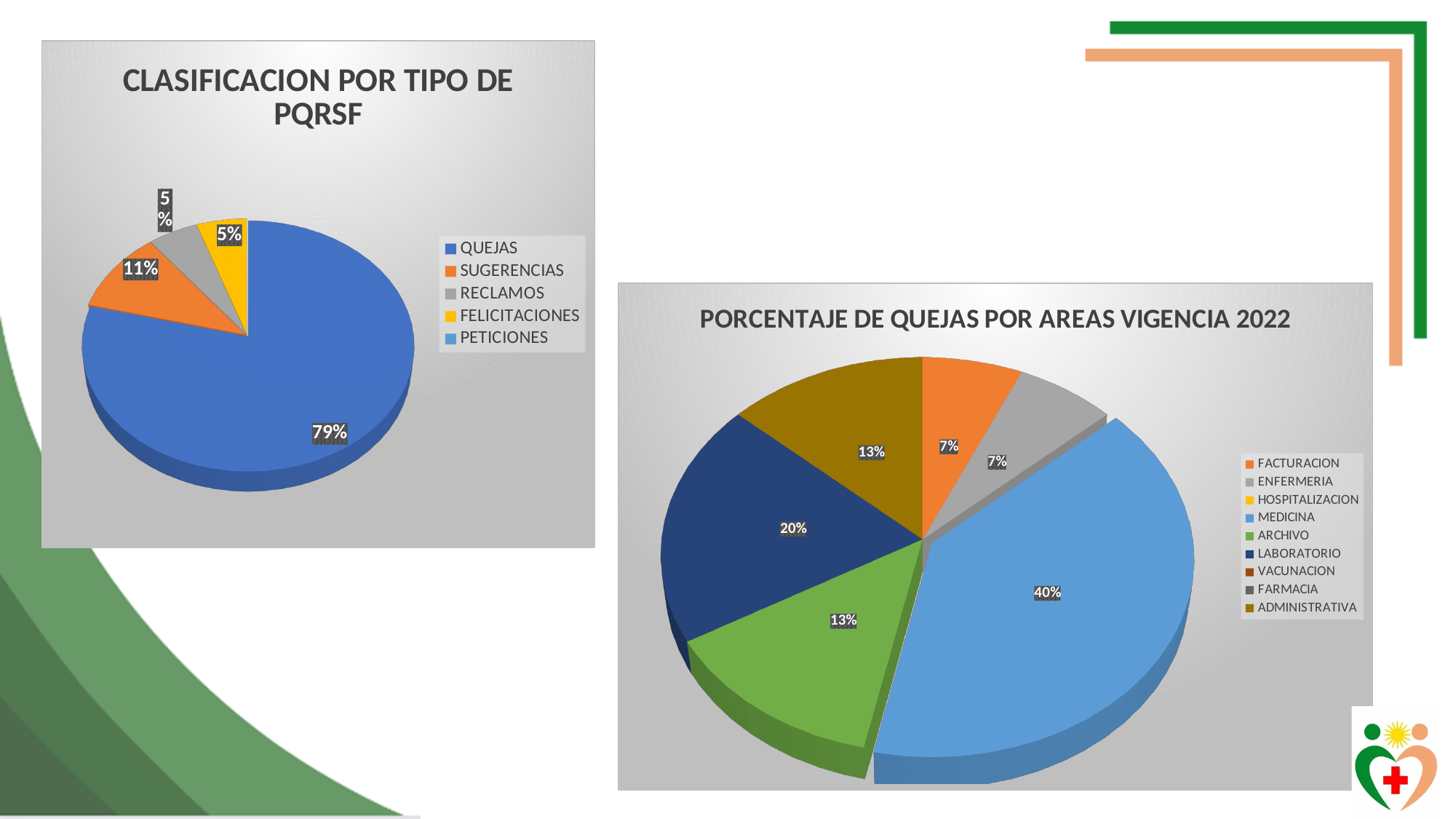
In the chart titled "PORCENTAJE DE QUEJAS POR AREAS VIGENCIA 2022", what percentage is shown for LABORATORIO? 20% In the chart titled "CLASIFICACION POR TIPO DE PQRSF", how many percentage points larger is QUEJAS than SUGERENCIAS? 68 percentage points In the chart titled "PORCENTAJE DE QUEJAS POR AREAS VIGENCIA 2022", which is larger, LABORATORIO or ARCHIVO? LABORATORIO In the chart titled "CLASIFICACION POR TIPO DE PQRSF", what percentage is shown for QUEJAS? 79% In the chart titled "CLASIFICACION POR TIPO DE PQRSF", how many entries does the legend list? 5 What kind of chart is the one titled "PORCENTAJE DE QUEJAS POR AREAS VIGENCIA 2022"? Pie chart In the chart titled "PORCENTAJE DE QUEJAS POR AREAS VIGENCIA 2022", what percentage is shown for MEDICINA? 40% In the chart titled "CLASIFICACION POR TIPO DE PQRSF", what percentage is shown for SUGERENCIAS? 11% In the chart titled "PORCENTAJE DE QUEJAS POR AREAS VIGENCIA 2022", which area has the largest share? MEDICINA In the chart titled "PORCENTAJE DE QUEJAS POR AREAS VIGENCIA 2022", what percentage is shown for ARCHIVO? 13% In the chart titled "CLASIFICACION POR TIPO DE PQRSF", which category has the largest share? QUEJAS In the chart titled "PORCENTAJE DE QUEJAS POR AREAS VIGENCIA 2022", how many entries does the legend list? 9